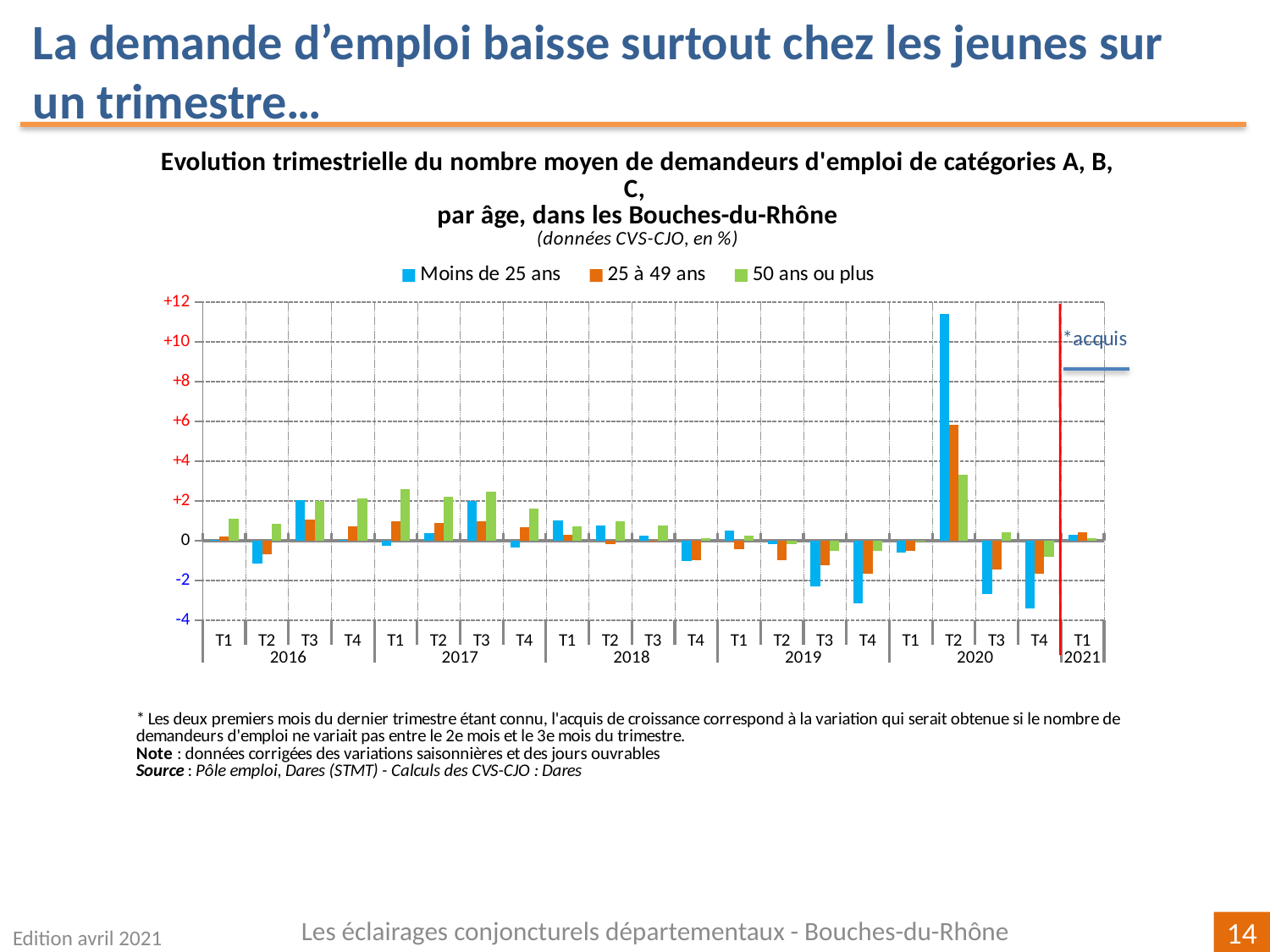
Is the value for 25 à 49 ans in T2 2020 greater or less than +4? greater Which colour represents the series 'Moins de 25 ans' in the legend? Blue In T1 2017, which is larger: the value for 50 ans ou plus or for Moins de 25 ans? 50 ans ou plus Is the value for Moins de 25 ans in T2 2020 greater or less than +10? greater In T2 2020, which is larger: the value for Moins de 25 ans or for 25 à 49 ans? Moins de 25 ans Which quarter and age group has the highest bar in the chart? T2 2020, Moins de 25 ans Is the value for Moins de 25 ans in T4 2019 greater or less than -2? less How many quarters are plotted along the x axis? 21 What kind of chart is shown on the slide? Bar chart How many series does the legend list? 3